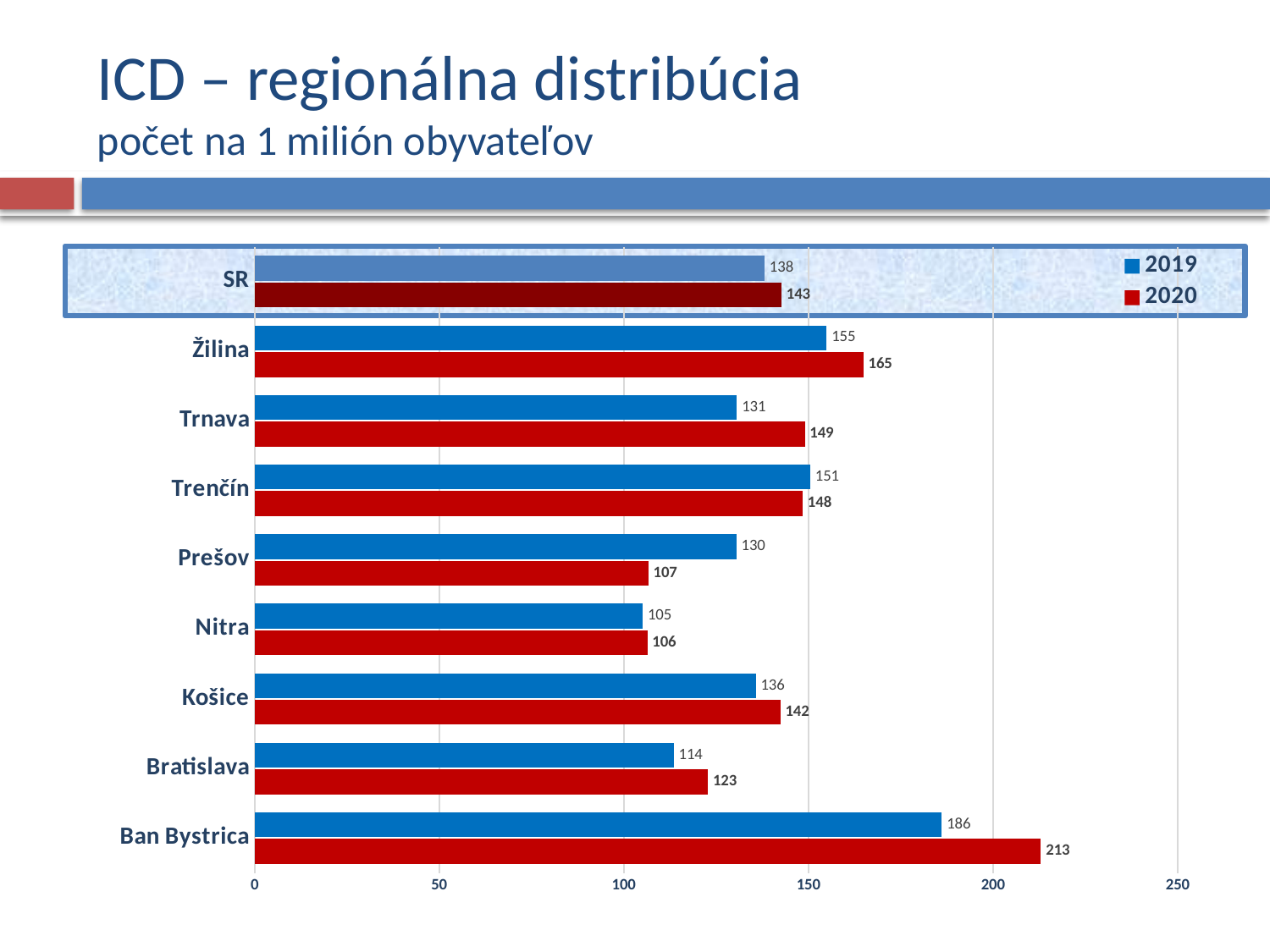
Which region has the highest 2020 value? Ban Bystrica How many series does the legend list? 2 Which colour represents the 2020 series in the legend? red What kind of chart is shown on the slide? bar chart What is the 2019 value for Trnava? 131 What is the difference between the 2020 and 2019 values for Žilina? 10 How many categories are shown on the y axis? 9 Which is larger for Prešov, the 2019 value or the 2020 value? 2019 What is the 2020 value for Ban Bystrica? 213 What is the 2020 value for SR? 143 Which category has the lowest 2019 value? Nitra Is the 2019 value for Ban Bystrica greater or less than 150? greater